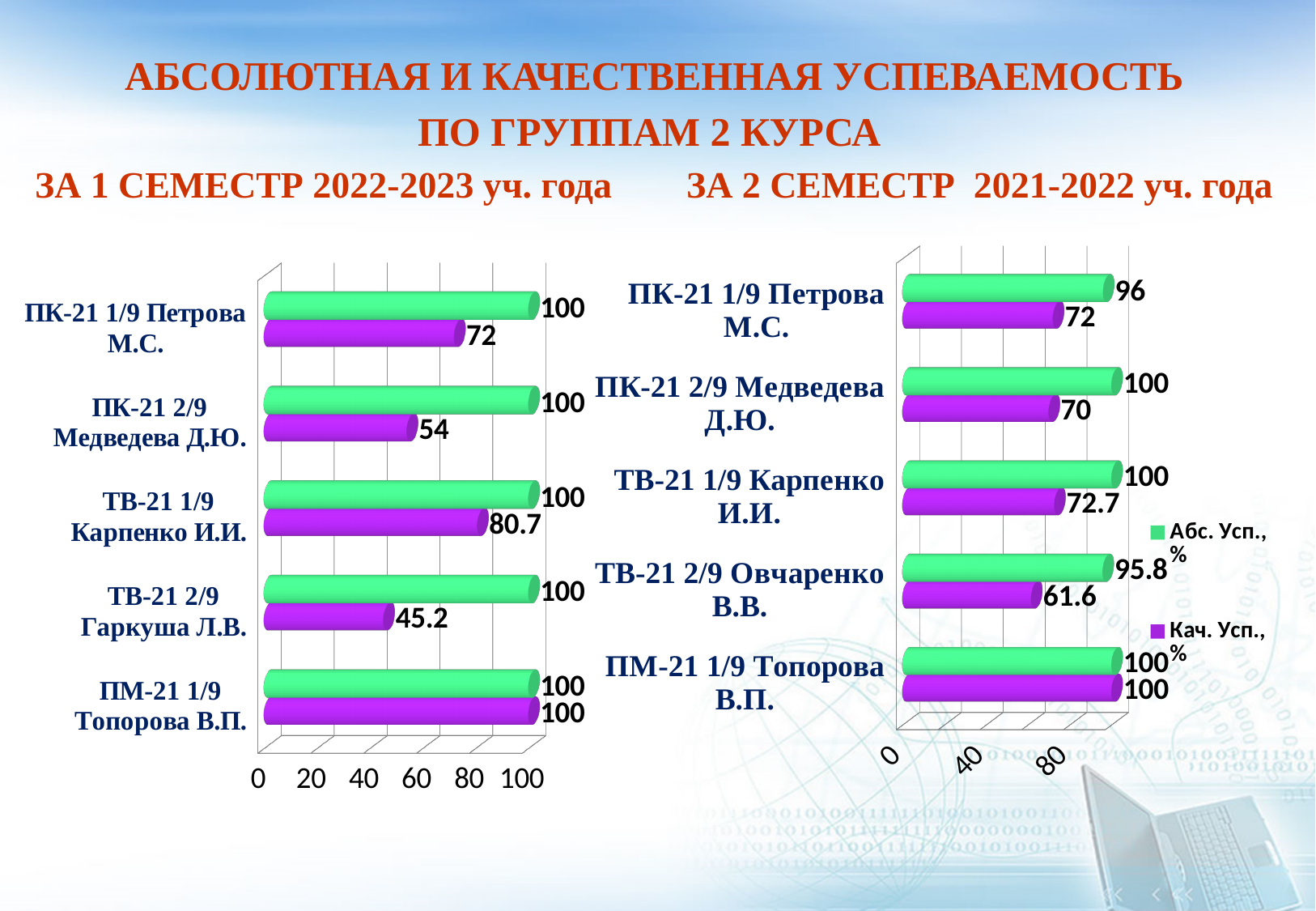
In the right chart (ЗА 2 СЕМЕСТР 2021-2022 уч. года), what is the Кач. Усп., % value for ТВ-21 1/9 Карпенко И.И.? 72.7 In the left chart (ЗА 1 СЕМЕСТР 2022-2023 уч. года), what is the Кач. Усп., % value for ТВ-21 2/9 Гаркуша Л.В.? 45.2 How many groups are shown in the left chart (ЗА 1 СЕМЕСТР 2022-2023 уч. года)? 5 In the right chart (ЗА 2 СЕМЕСТР 2021-2022 уч. года), what is the Абс. Усп., % value for ТВ-21 2/9 Овчаренко В.В.? 95.8 In the left chart (ЗА 1 СЕМЕСТР 2022-2023 уч. года), what is the Кач. Усп., % value for ПК-21 2/9 Медведева Д.Ю.? 54 In the left chart (ЗА 1 СЕМЕСТР 2022-2023 уч. года), what is the difference between the Абс. Усп., % and Кач. Усп., % values for ТВ-21 1/9 Карпенко И.И.? 19.3 How many series does the legend list? 2 In the right chart (ЗА 2 СЕМЕСТР 2021-2022 уч. года), which group has the lowest Кач. Усп., % value? ТВ-21 2/9 Овчаренко В.В. In the left chart (ЗА 1 СЕМЕСТР 2022-2023 уч. года), which group has the lowest Кач. Усп., % value? ТВ-21 2/9 Гаркуша Л.В. What type of chart is used on this slide? Bar chart In the right chart (ЗА 2 СЕМЕСТР 2021-2022 уч. года), which is larger: the Кач. Усп., % value for ПК-21 1/9 Петрова М.С. or for ТВ-21 2/9 Овчаренко В.В.? ПК-21 1/9 Петрова М.С. In the right chart (ЗА 2 СЕМЕСТР 2021-2022 уч. года), what is the difference between the Абс. Усп., % values for ПК-21 2/9 Медведева Д.Ю. and ПК-21 1/9 Петрова М.С.? 4